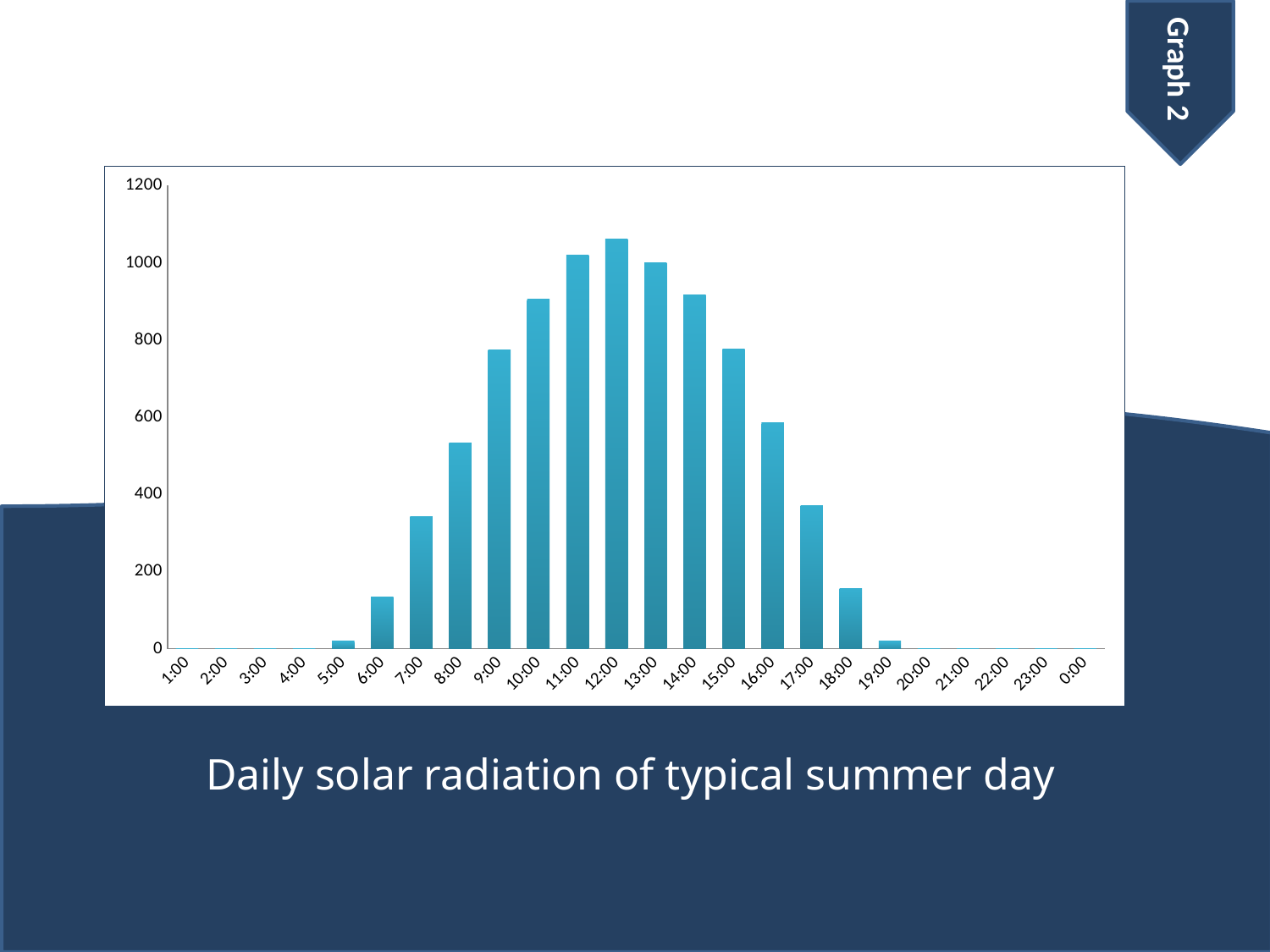
Which is larger, the value at 10:00 or the value at 16:00? 10:00 How many time categories are shown on the x axis? 24 Do the values rise or fall from 12:00 to 19:00? fall What kind of chart is shown on the slide? Bar chart Is the value at 18:00 greater or less than 200? less Is the value at 7:00 greater or less than 400? less Is the value at 8:00 greater or less than 400? greater Which is larger, the value at 8:00 or the value at 17:00? 8:00 What is the caption of the chart on the slide? Daily solar radiation of typical summer day At which time is the solar radiation highest? 12:00